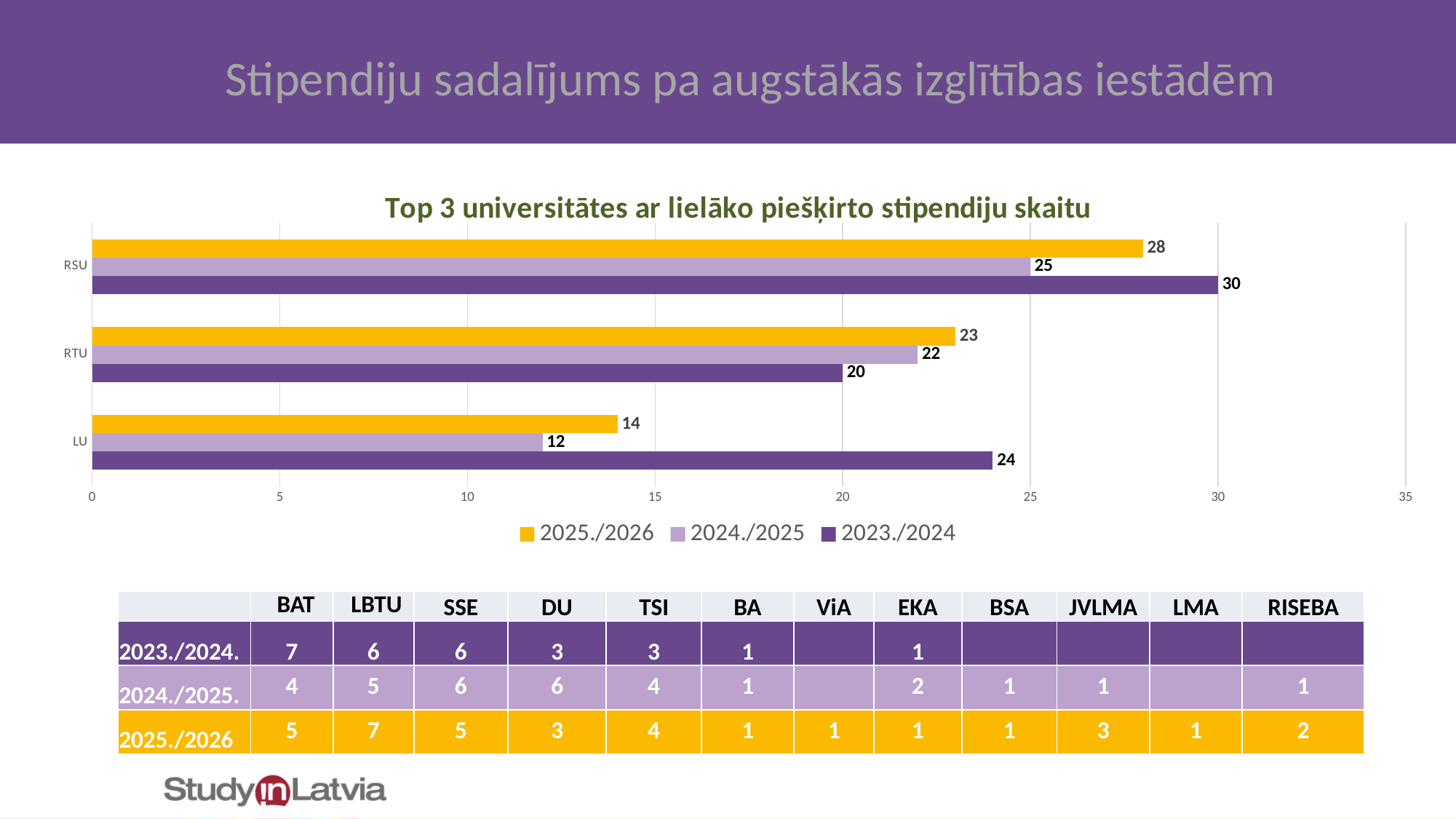
How many series does the chart legend list? 3 Which university has the lowest value in the 2024./2025 series? LU How many universities are shown on the chart? 3 Which is larger for RTU: the 2025./2026 value or the 2023./2024 value? 2025./2026 What is the title of the chart? Top 3 universitātes ar lielāko piešķirto stipendiju skaitu What is the difference between the 2023./2024 and 2025./2026 values for LU? 10 What kind of chart is shown on the slide? bar chart Which university has the highest value in the 2025./2026 series? RSU What is the value for RSU in the 2023./2024 series? 30 What is the value for LU in the 2024./2025 series? 12 Is the 2024./2025 value for RSU greater or less than 20? greater What is the value for RTU in the 2025./2026 series? 23